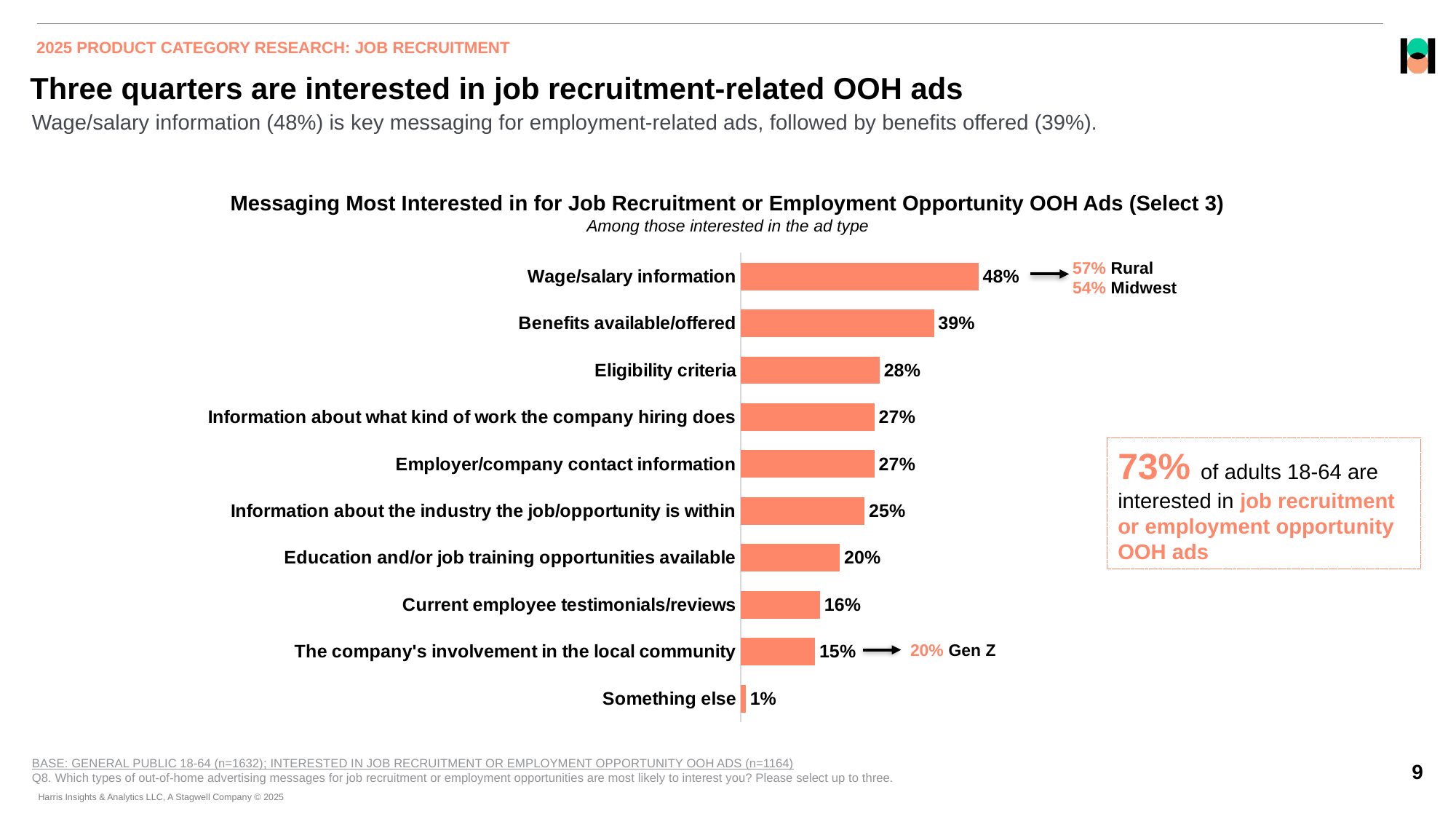
Which messaging category has the highest value? Wage/salary information Which is larger: Information about the industry the job/opportunity is within or Current employee testimonials/reviews? Information about the industry the job/opportunity is within What percentage is shown for Wage/salary information? 48% What is the difference between Wage/salary information and Benefits available/offered? 9 percentage points What percentage of Rural respondents is called out for Wage/salary information? 57% What percentage of Gen Z is called out for The company's involvement in the local community? 20% What kind of chart is shown on the slide? Bar chart What percentage is shown for Current employee testimonials/reviews? 16% What is the difference between Eligibility criteria and The company's involvement in the local community? 13 percentage points How many messaging categories are shown in the chart? 10 Which messaging category has the lowest value? Something else What is the value for Education and/or job training opportunities available? 20%